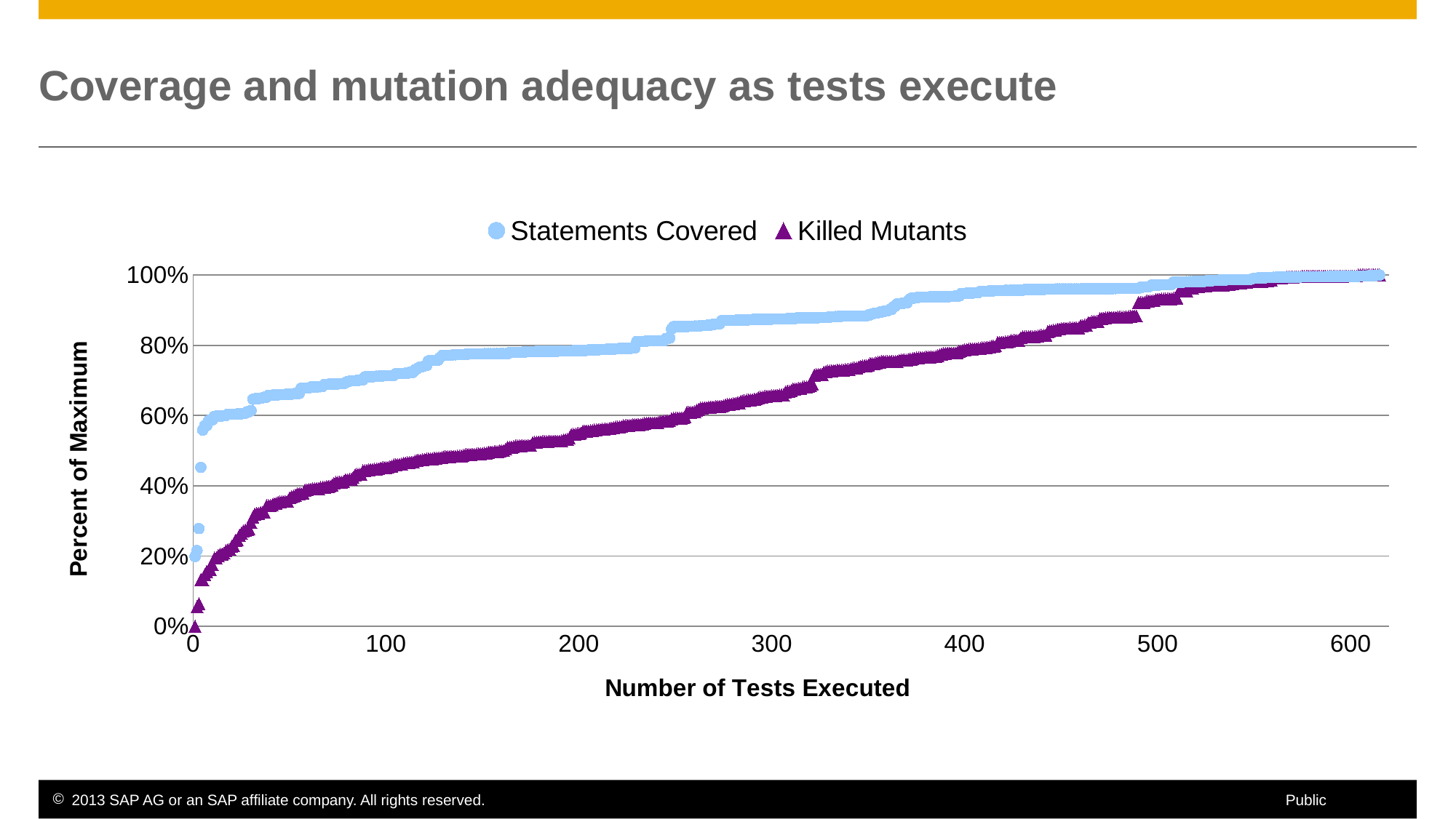
What are the two series named in the legend? Statements Covered and Killed Mutants Is the Statements Covered value at 100 tests executed greater or less than 60%? greater Is the Statements Covered value at 300 tests executed greater or less than 80%? greater Is the Killed Mutants value at 100 tests executed greater or less than 60%? less How many series does the legend list? 2 What kind of chart is shown on the slide? Scatter chart At 200 tests executed, which series has the higher value, Statements Covered or Killed Mutants? Statements Covered Do the Killed Mutants values rise or fall as the number of tests executed increases? Rise What is the title of the chart's x axis? Number of Tests Executed Do the Statements Covered values rise or fall along the x axis? Rise